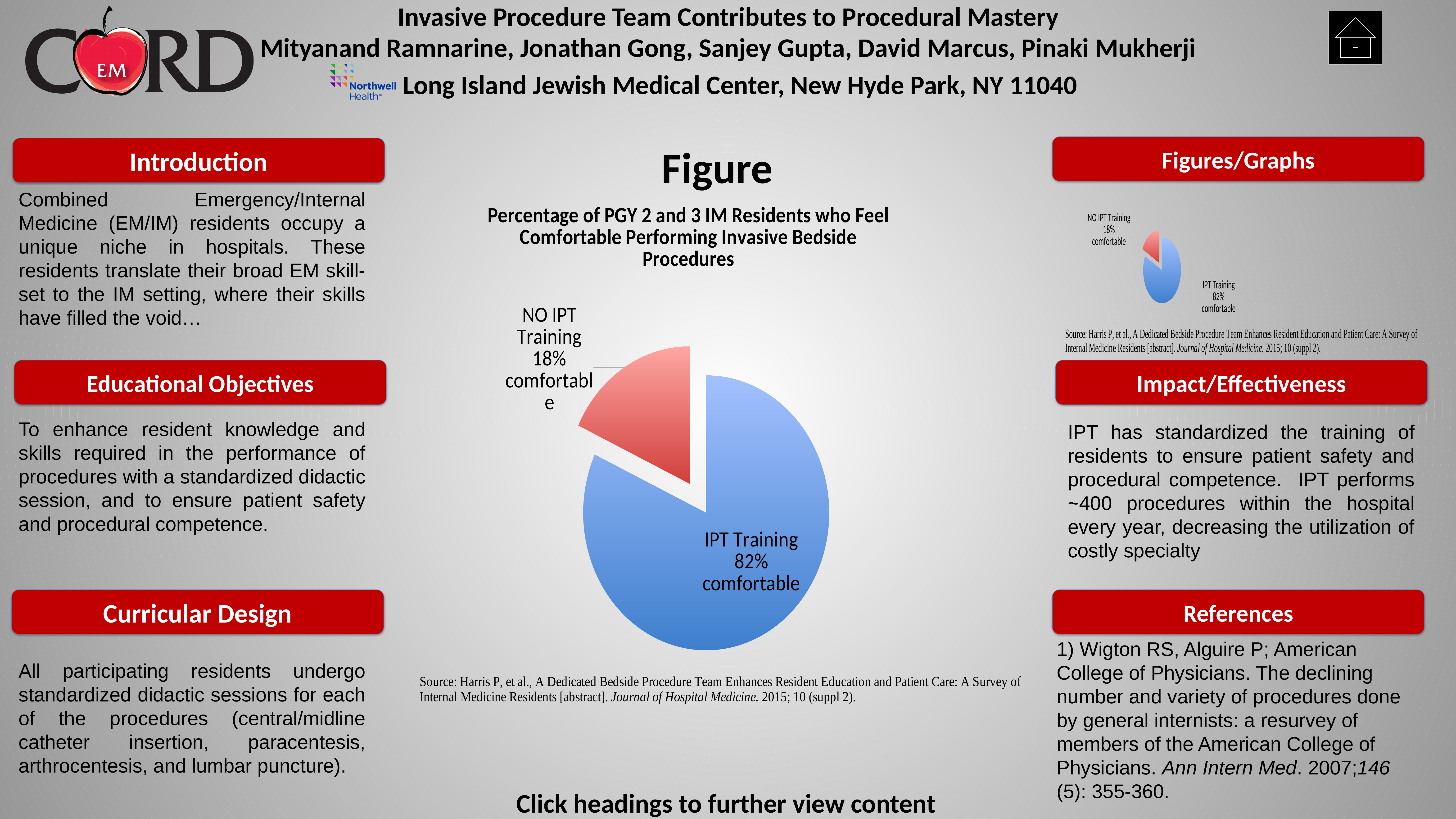
In the large central chart, what percentage of residents with IPT Training feel comfortable performing invasive bedside procedures? 82% In the large central chart, what is the difference in percentage points between the IPT Training and NO IPT Training slices? 64 In the large central chart, which is larger: the IPT Training slice or the NO IPT Training slice? IPT Training How many slices does the large central pie chart have? 2 In the small pie chart in the Figures/Graphs section, what percentage is shown for IPT Training? 82% What type of chart is the large central figure? Pie chart In the large central chart, what percentage of residents with NO IPT Training feel comfortable? 18% What is the title of the large central chart? Percentage of PGY 2 and 3 IM Residents who Feel Comfortable Performing Invasive Bedside Procedures In the large central chart, what share of the pie does the NO IPT Training slice represent? 18% In the large central chart, which slice is the largest? IPT Training In the large central chart, which slice is the smallest? NO IPT Training In the large central chart, what colour is the IPT Training slice? Blue